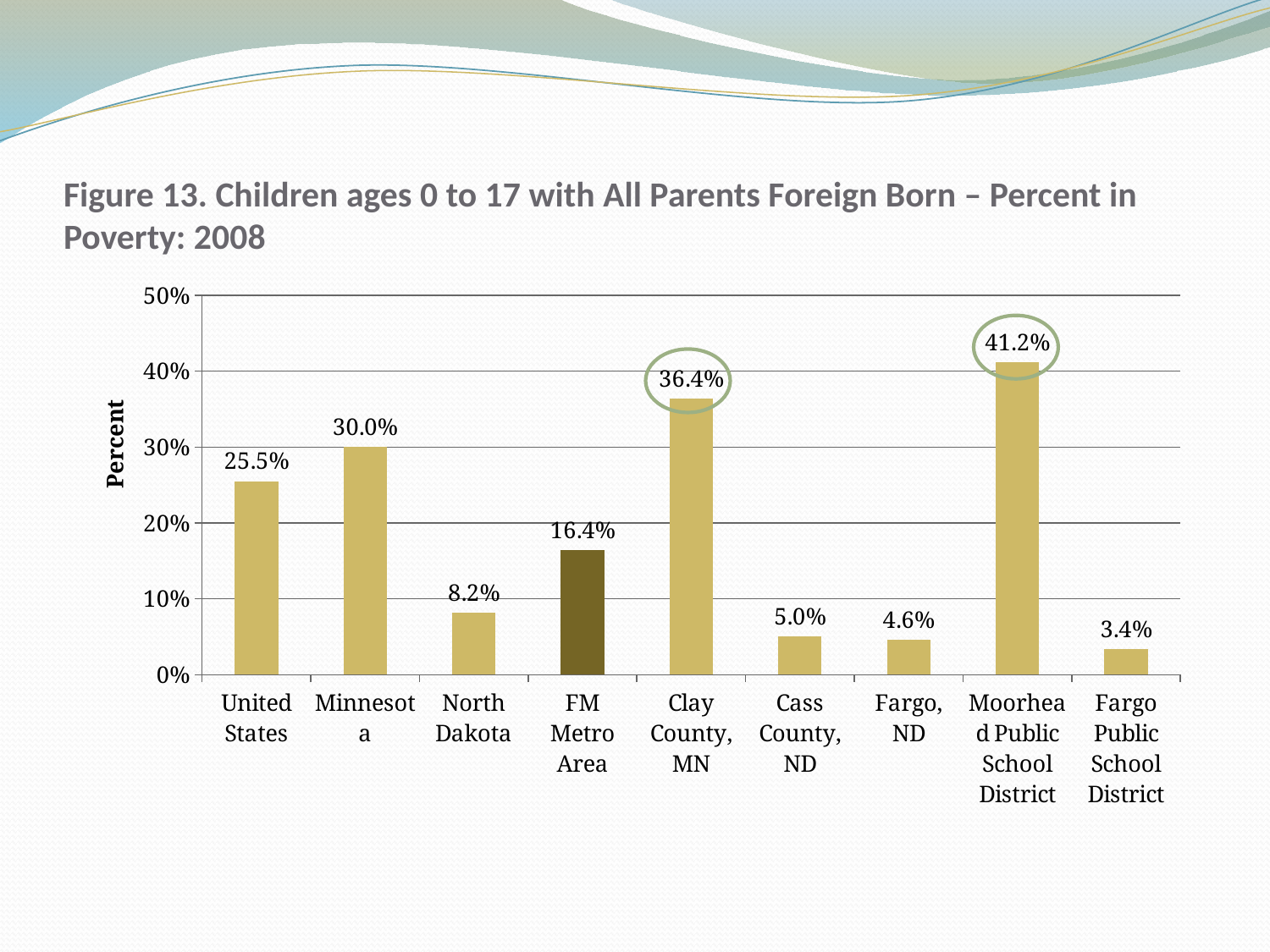
Which category has the lowest percent in poverty? Fargo Public School District What is the label on the vertical axis? Percent How many categories are shown on the x axis? 9 What is the percent in poverty for the FM Metro Area? 16.4% What is the difference between the percent in poverty for Minnesota and the United States? 4.5% Which category has the highest percent in poverty? Moorhead Public School District What is the percent in poverty for Clay County, MN? 36.4% What kind of chart is shown on the slide? Bar chart What is the percent in poverty for Fargo Public School District? 3.4% What is the difference between the percent in poverty for Moorhead Public School District and Clay County, MN? 4.8% Is the value for Minnesota greater or less than 20%? greater Which has a higher percent in poverty, North Dakota or Cass County, ND? North Dakota